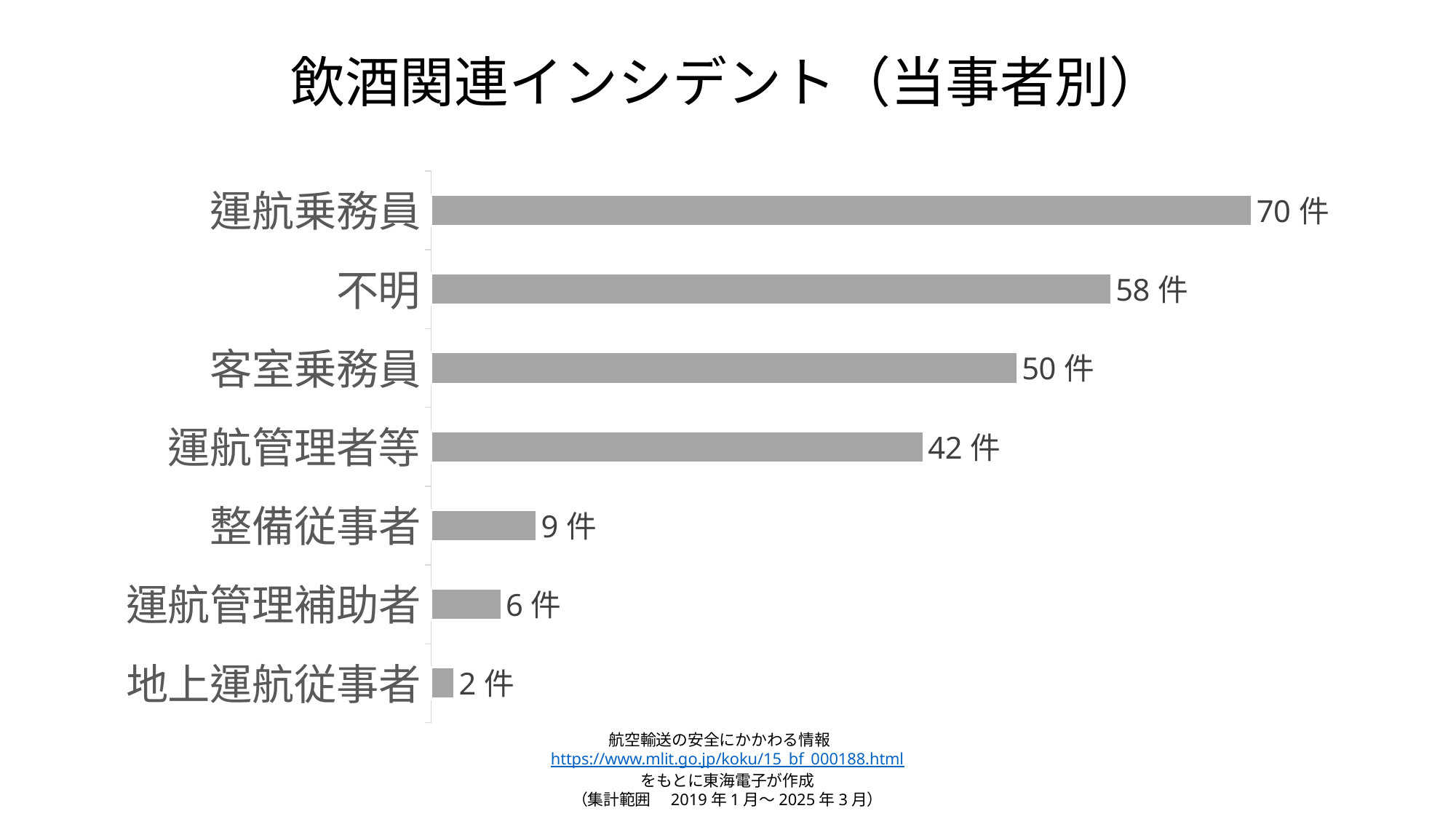
How many categories are shown in the chart? 7 What is the difference between the values for 運航乗務員 and 不明? 12 件 Which category has the lowest value? 地上運航従事者 Which category has the highest value? 運航乗務員 What is the value for 不明? 58 件 What is the value for 客室乗務員? 50 件 What kind of chart is shown on the slide? Bar chart Which is larger, the value for 整備従事者 or the value for 運航管理補助者? 整備従事者 What is the difference between the values for 客室乗務員 and 運航管理者等? 8 件 What is the value for 運航管理補助者? 6 件 What is the title of the chart? 飲酒関連インシデント（当事者別） What is the value for 運航乗務員? 70 件